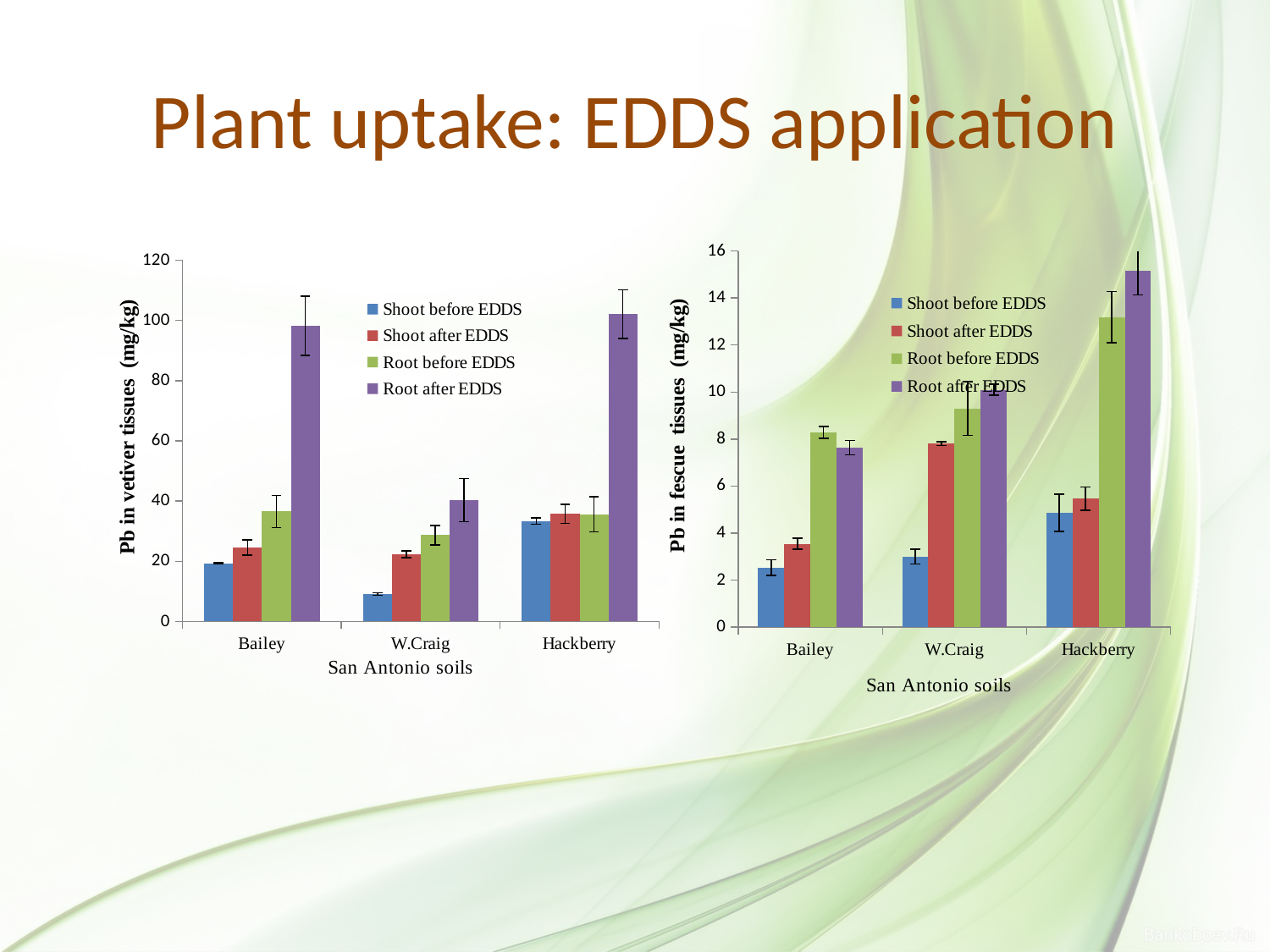
In the right chart (Pb in fescue tissues), which soil has the highest Root before EDDS value? Hackberry In the left chart (Pb in vetiver tissues), is the value for Root after EDDS in Bailey greater or less than 80? greater In the left chart (Pb in vetiver tissues), which soil has the highest Root after EDDS value? Hackberry How many soil categories are shown on the x axis of the left chart (Pb in vetiver tissues)? 3 In the right chart (Pb in fescue tissues), which is larger for W.Craig: Shoot before EDDS or Shoot after EDDS? Shoot after EDDS In the left chart (Pb in vetiver tissues), is the value for Shoot before EDDS in W.Craig greater or less than 20? less How many series does the legend of the right chart (Pb in fescue tissues) list? 4 In the left chart (Pb in vetiver tissues), which soil has the lowest Shoot before EDDS value? W.Craig What kind of chart is the left chart (Pb in vetiver tissues)? bar chart What is the x-axis label of the right chart (Pb in fescue tissues)? San Antonio soils In the right chart (Pb in fescue tissues), is the value for Shoot before EDDS in Bailey greater or less than 4? less